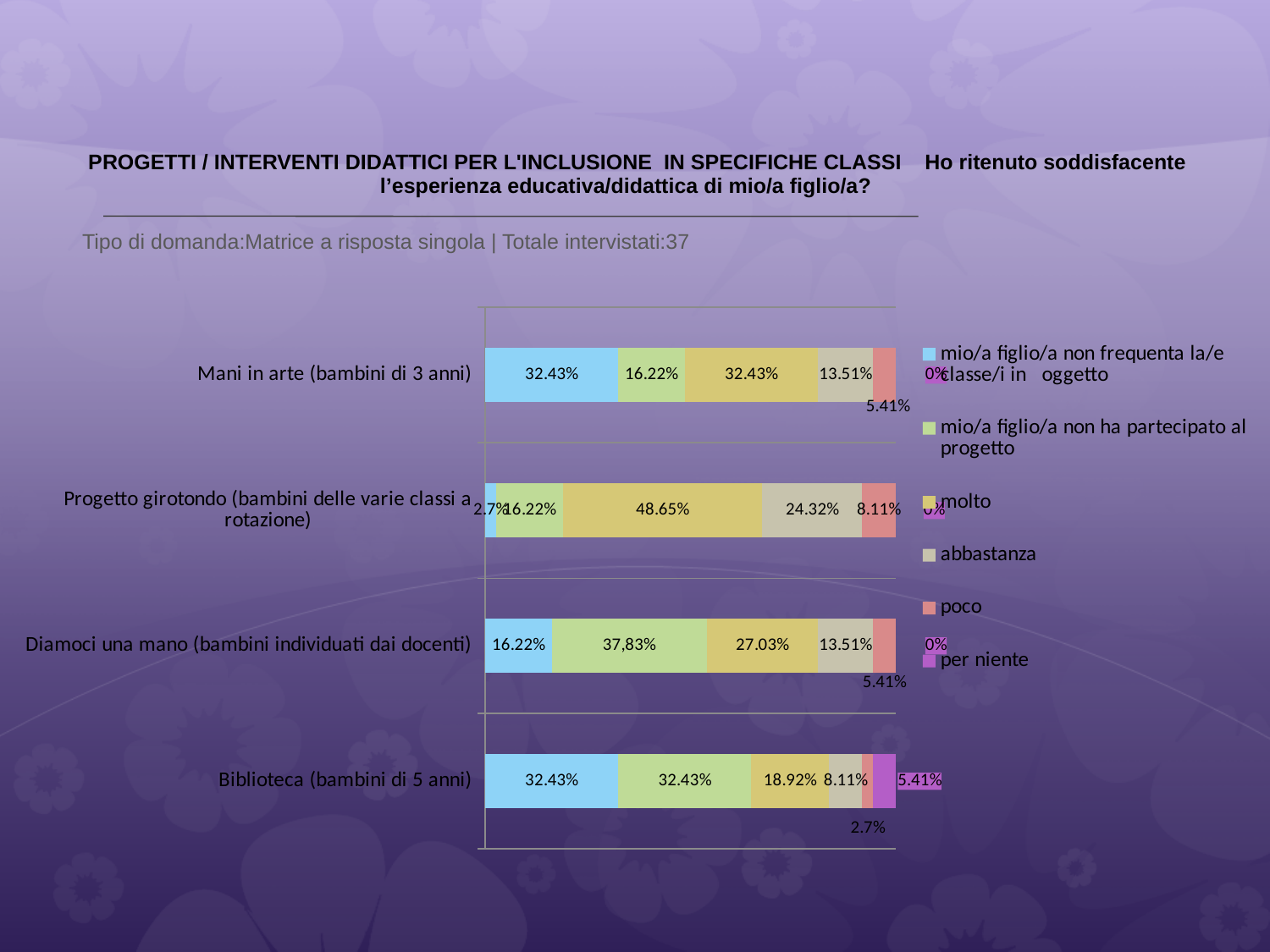
What is the value of "abbastanza" for Mani in arte (bambini di 3 anni)? 13.51% How many projects (categories) are shown in the chart? 4 How many series does the legend list? 6 What is the value of "poco" for Progetto girotondo (bambini delle varie classi a rotazione)? 8.11% What kind of chart is shown on the slide? Stacked bar chart Which project has the lowest value for "molto"? Biblioteca (bambini di 5 anni) What is the value of "per niente" for Biblioteca (bambini di 5 anni)? 5.41% What is the difference between the "molto" values for Progetto girotondo and Mani in arte? 16.22% What is the value of "mio/a figlio/a non ha partecipato al progetto" for Diamoci una mano (bambini individuati dai docenti)? 37,83% What percentage of respondents answered "molto" for Progetto girotondo (bambini delle varie classi a rotazione)? 48.65% Which project has the highest value for "molto"? Progetto girotondo (bambini delle varie classi a rotazione) Which has a larger "poco" value: Progetto girotondo or Mani in arte? Progetto girotondo